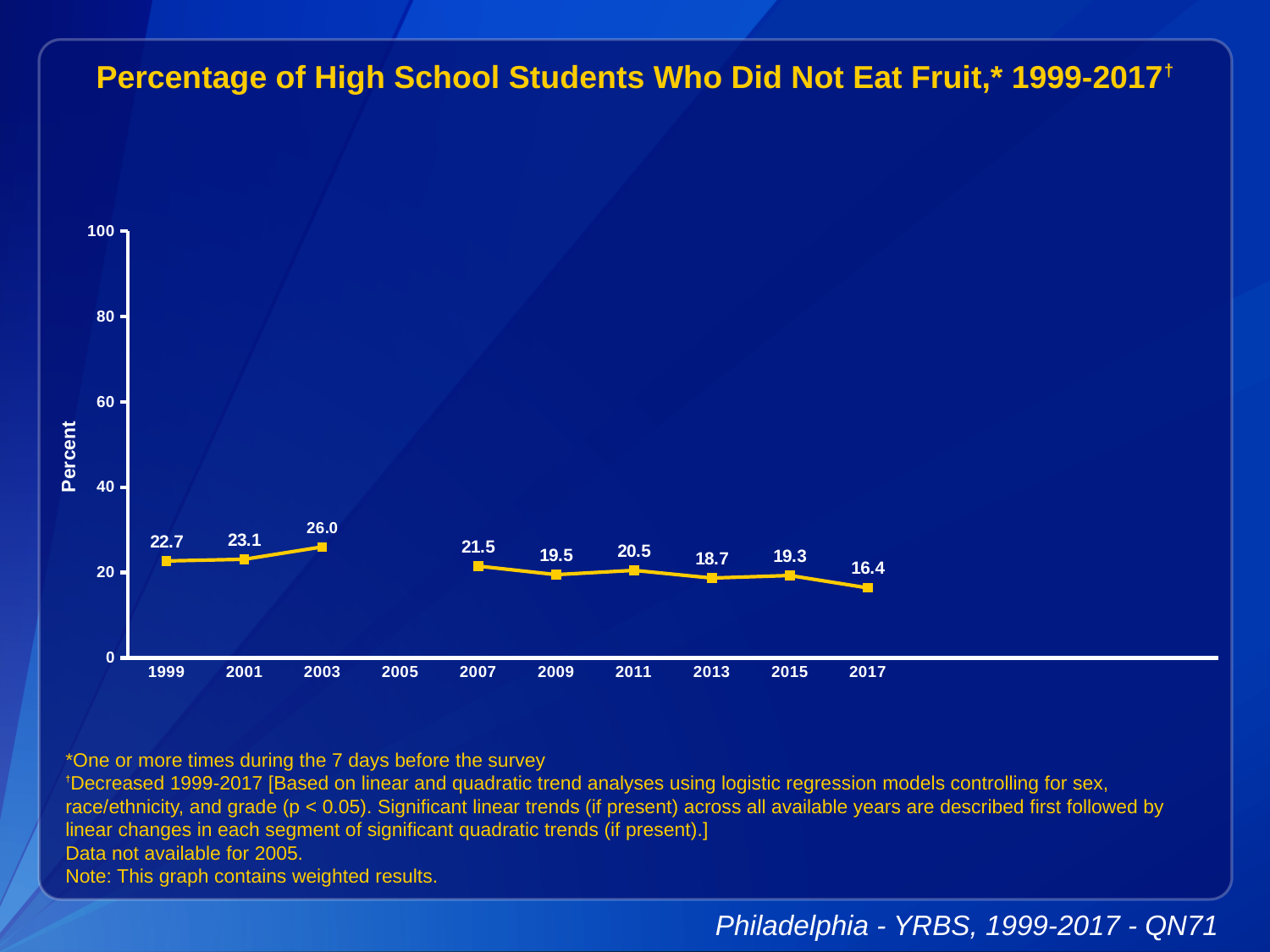
Which year has the highest percentage of students who did not eat fruit? 2003 What is the value plotted for 2017? 16.4 Is the value for 2003 greater or less than 20? greater Which year has a larger value, 2007 or 2013? 2007 What is the difference between the 2003 value and the 2017 value? 9.6 What percentage of high school students did not eat fruit in 1999? 22.7 How many years have data points plotted on the chart? 9 What is the value plotted for 2011? 20.5 Do the values generally rise or fall from 2007 to 2017? Fall What kind of chart is shown on the slide? Line chart Which year on the x axis has no data plotted? 2005 Which year has the lowest percentage of students who did not eat fruit? 2017